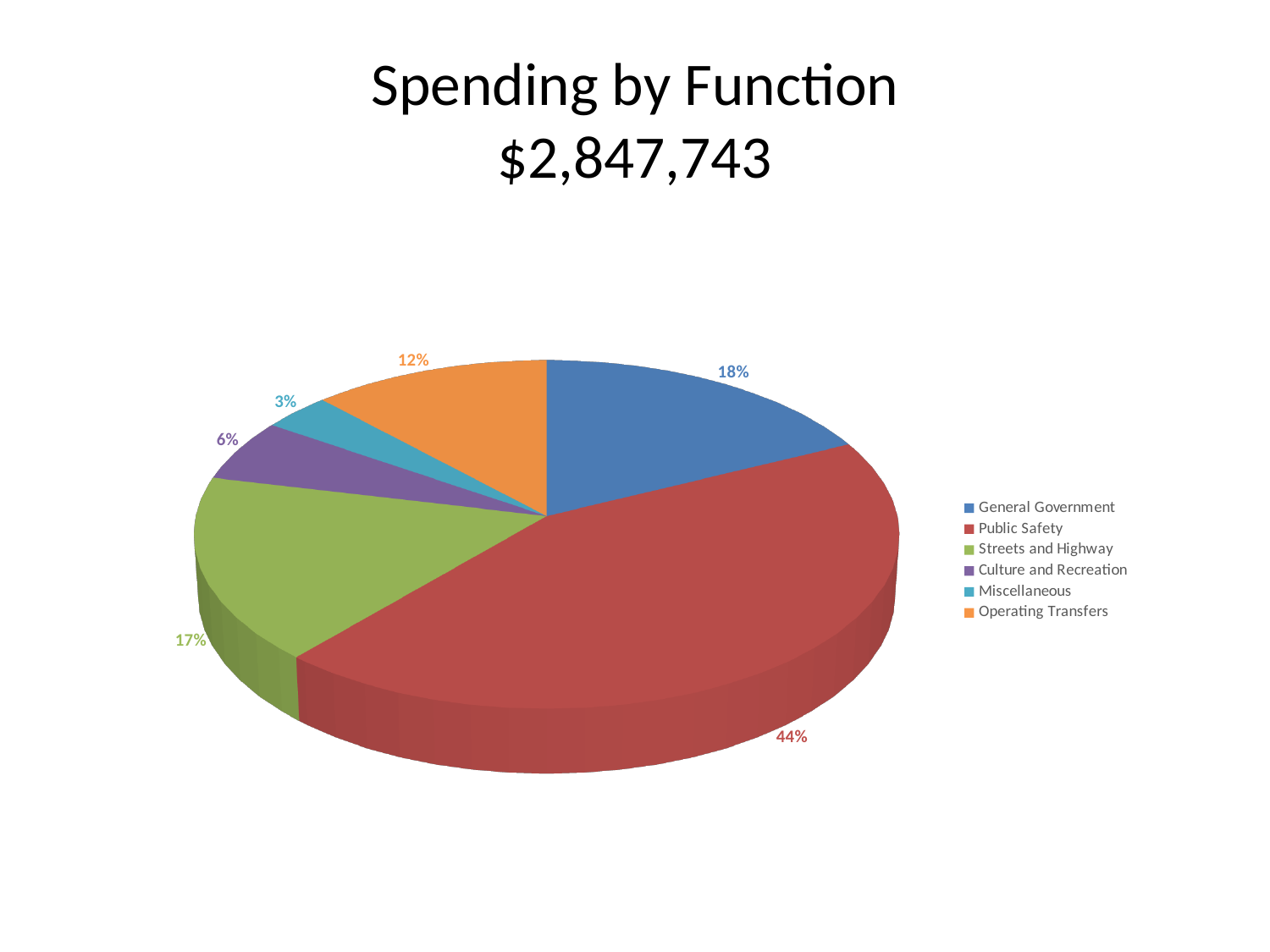
What type of chart is shown on the slide? Pie chart How many functions are shown in the pie chart? 6 What share of spending does Operating Transfers account for? 12% Which has a larger share, Operating Transfers or Culture and Recreation? Operating Transfers What share of spending does Culture and Recreation account for? 6% What is the difference in percentage points between Public Safety and General Government? 26 Which function has the largest share of spending? Public Safety Which function has the smallest share of spending? Miscellaneous What share of spending does Miscellaneous account for? 3%